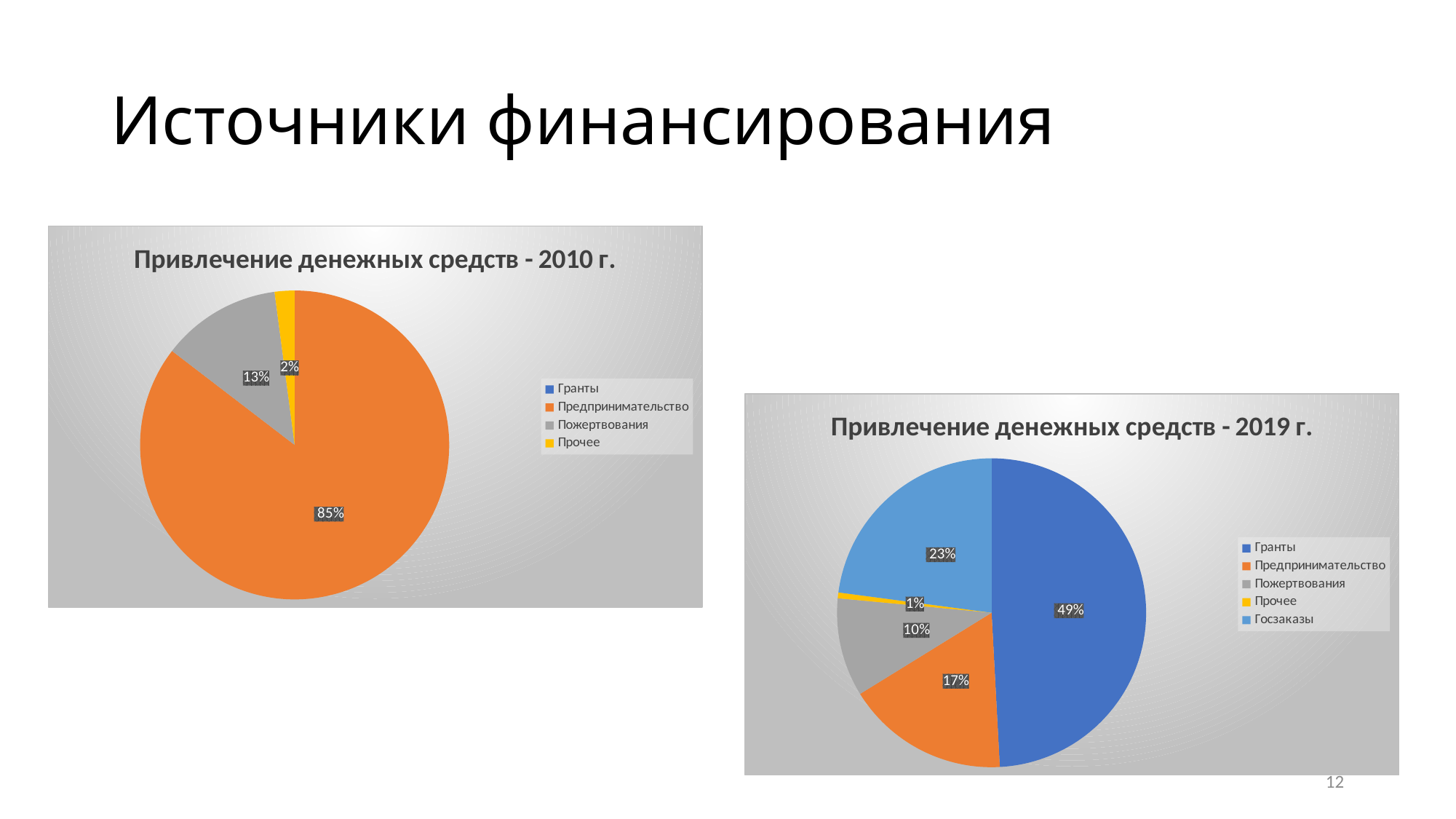
In the chart titled "Привлечение денежных средств - 2019 г.", which is larger: Госзаказы or Предпринимательство? Госзаказы In the chart titled "Привлечение денежных средств - 2019 г.", what is the difference between the shares of Предпринимательство and Пожертвования? 7% In the chart titled "Привлечение денежных средств - 2019 г.", what share does Гранты have? 49% What type of chart is the chart titled "Привлечение денежных средств - 2010 г."? Pie chart In the chart titled "Привлечение денежных средств - 2010 г.", what share does Пожертвования have? 13% How many entries does the legend of the chart titled "Привлечение денежных средств - 2019 г." list? 5 In the chart titled "Привлечение денежных средств - 2010 г.", what share does Предпринимательство have? 85% In the chart titled "Привлечение денежных средств - 2010 г.", what colour is the Предпринимательство slice? Orange In the chart titled "Привлечение денежных средств - 2010 г.", what share does Прочее have? 2% In the chart titled "Привлечение денежных средств - 2019 г.", which category has the smallest slice? Прочее In the chart titled "Привлечение денежных средств - 2019 г.", which category has the largest slice? Гранты In the chart titled "Привлечение денежных средств - 2019 г.", what share does Госзаказы have? 23%